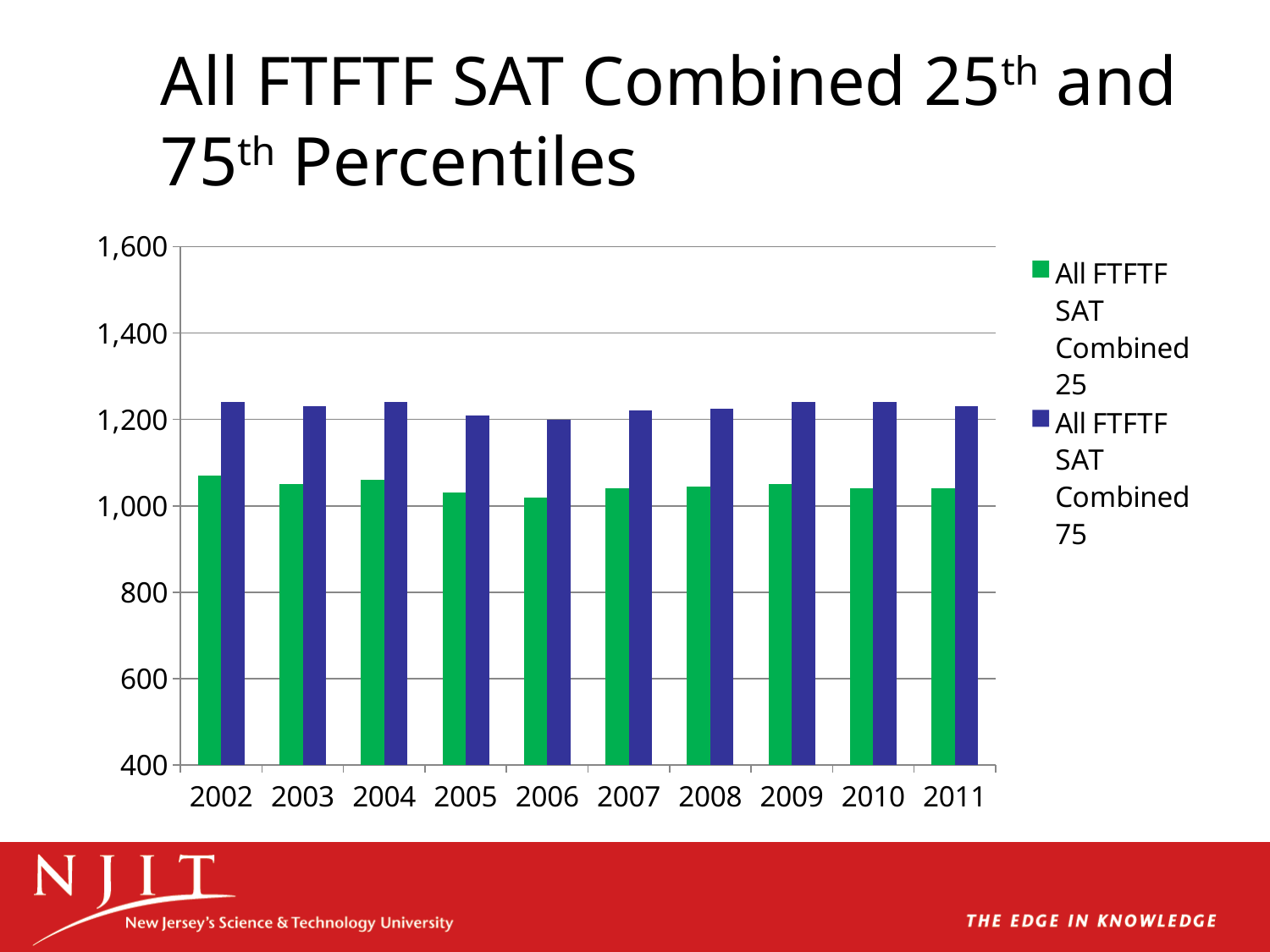
Which year has the lowest value for All FTFTF SAT Combined 75? 2006 Is the value for All FTFTF SAT Combined 75 in 2009 greater or less than 1,200? greater How many years are shown on the x axis of the chart? 10 Is the value for All FTFTF SAT Combined 25 in 2006 greater or less than 1,200? less What kind of chart is shown on the slide? Bar chart How many series does the chart's legend list? 2 Which is larger: the All FTFTF SAT Combined 25 value in 2002 or in 2006? 2002 Which colour represents All FTFTF SAT Combined 75 in the chart? Blue Is the value for All FTFTF SAT Combined 25 in 2002 greater or less than 1,000? greater Which is larger: the All FTFTF SAT Combined 75 value in 2006 or in 2009? 2009 Which year has the lowest value for All FTFTF SAT Combined 25? 2006